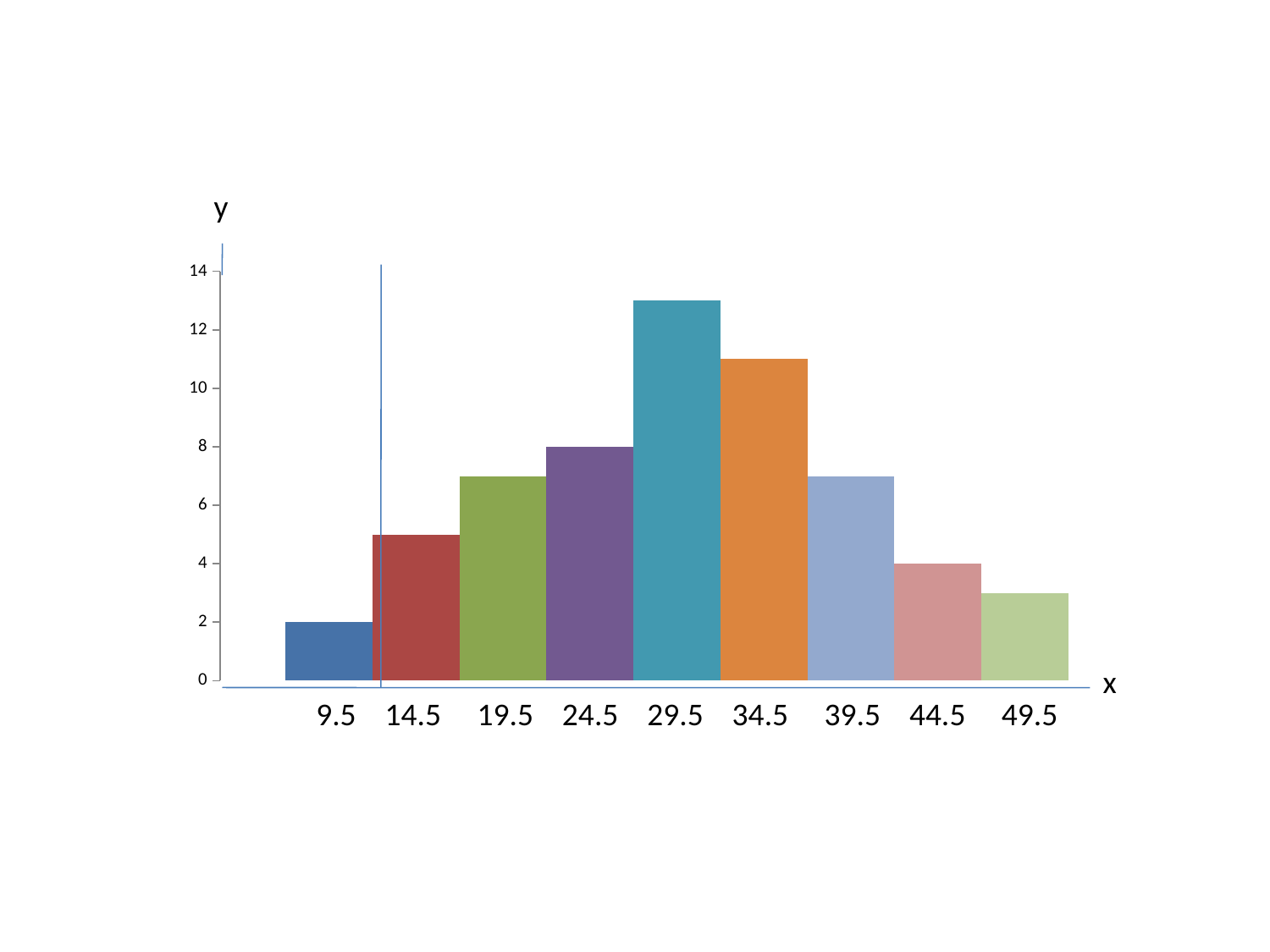
Which x-axis category has the tallest bar? 29.5 How many bars are plotted on the chart? 9 Which x-axis category has the shortest bar? 9.5 Do the bar values rise or fall from 9.5 to 29.5 along the x axis? rise Is the value for 29.5 greater or less than 12? greater What is the value of the bar at 44.5? 4 What is the value of the bar at 9.5? 2 Is the value for 49.5 greater or less than 4? less Which bar is taller, the one at 29.5 or the one at 34.5? 29.5 What is the difference between the bar at 24.5 and the bar at 9.5? 6 What is the value of the bar at 24.5? 8 What kind of chart is shown on the slide? bar chart